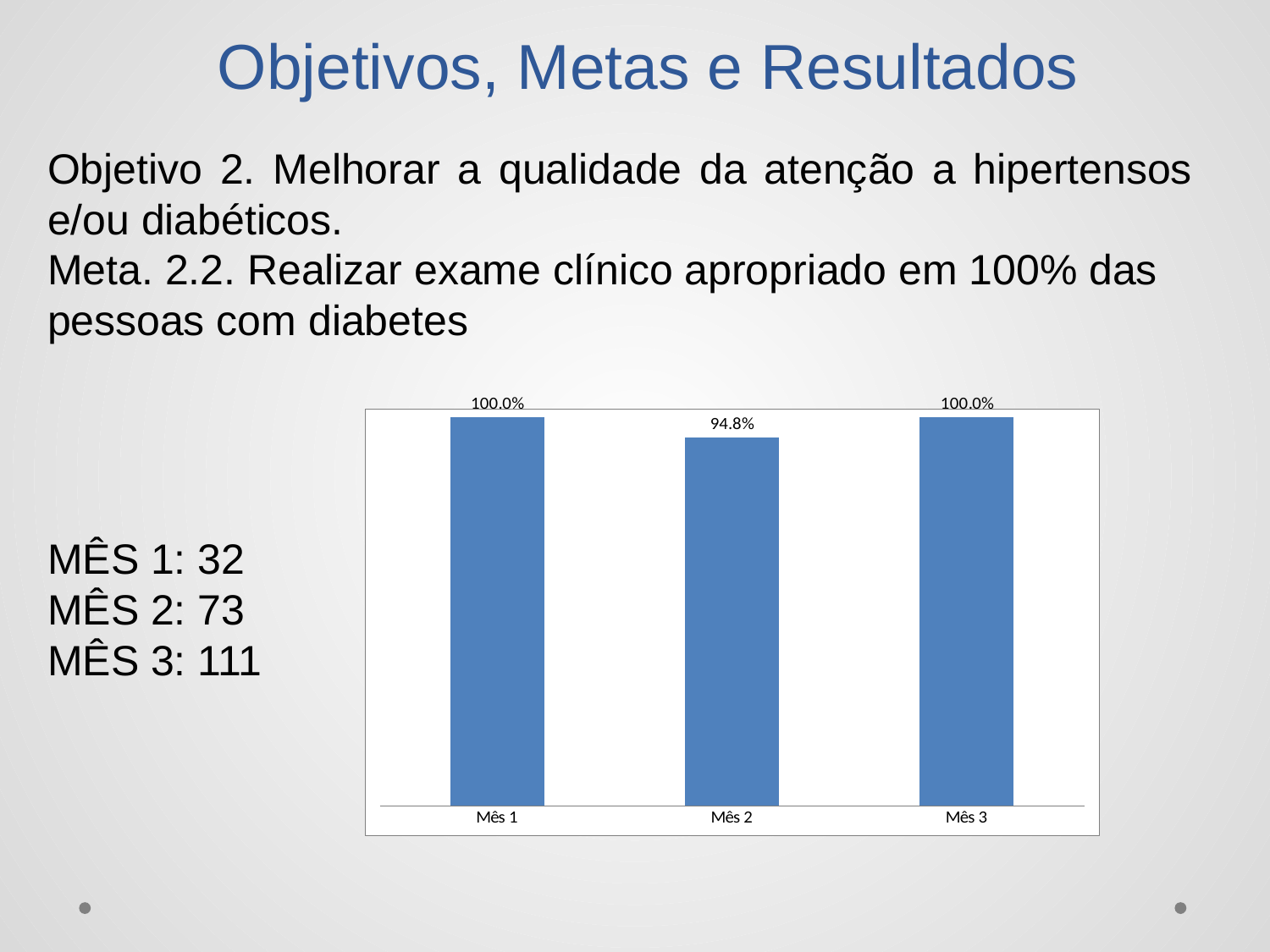
Does the value fall or rise from Mês 2 to Mês 3? Rise What colour are the bars in the chart? Blue What kind of chart is shown on the slide? Bar chart How many categories are shown on the x axis? 3 What is the difference between the values for Mês 1 and Mês 2? 5.2% Which month has the lowest value? Mês 2 What is the value for Mês 3? 100.0% Which is larger, the value for Mês 2 or the value for Mês 3? Mês 3 Do the values for Mês 1 and Mês 3 have the same value? Yes What is the value for Mês 1? 100.0% What is the value for Mês 2? 94.8%